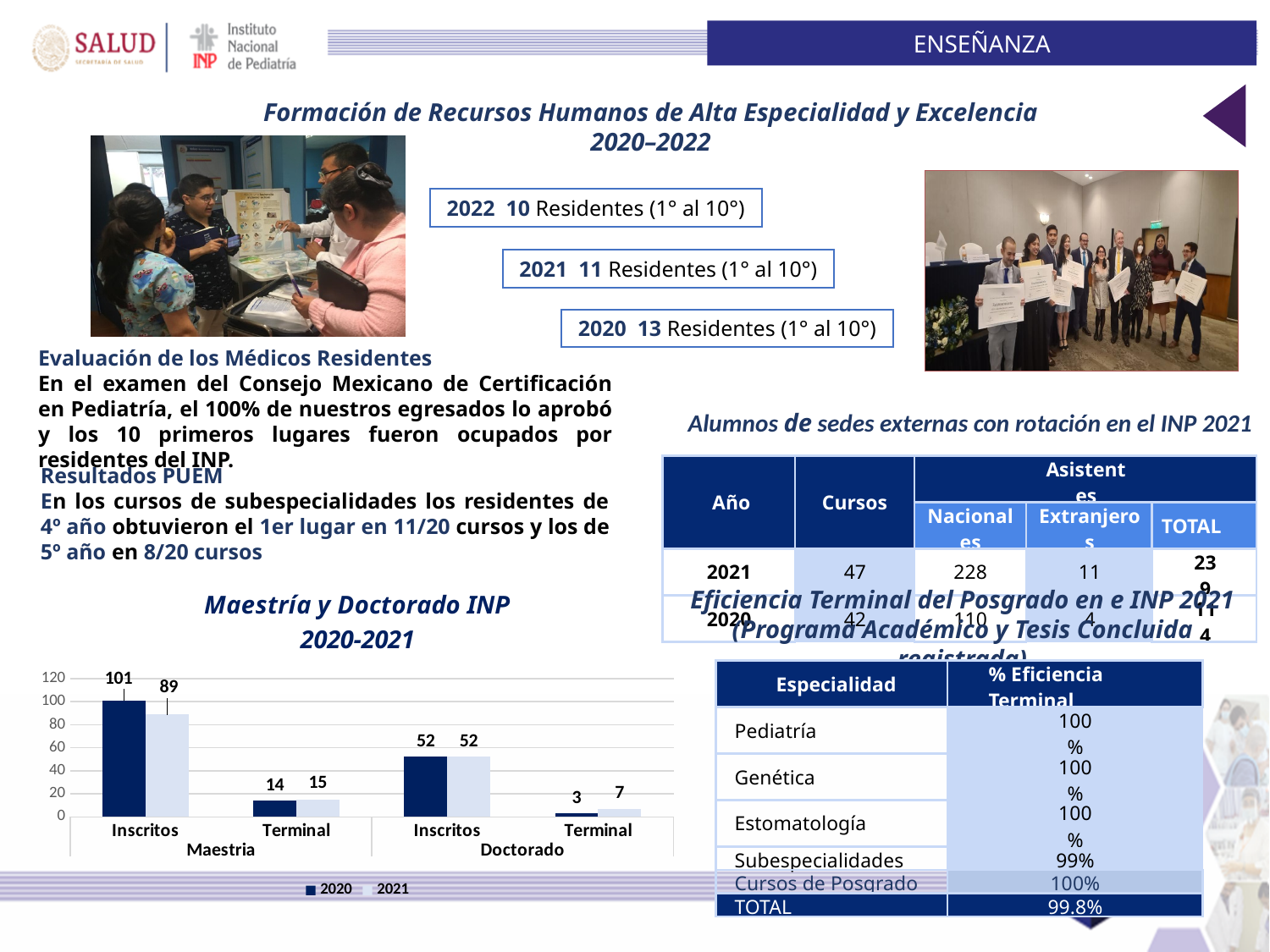
In the 'Maestría y Doctorado INP 2020-2021' chart, which category has the lowest 2020 value? Terminal (Doctorado) In the 'Maestría y Doctorado INP 2020-2021' chart, how many series does the legend list? 2 In the 'Maestría y Doctorado INP 2020-2021' chart, what are the 2020 and 2021 values for Inscritos in Doctorado? 52 and 52 In the 'Maestría y Doctorado INP 2020-2021' chart, what is the 2020 value for Terminal in Maestria? 14 In the 'Maestría y Doctorado INP 2020-2021' chart, which category has the highest 2020 value? Inscritos (Maestria) In the 'Maestría y Doctorado INP 2020-2021' chart, what is the difference between the 2020 and 2021 values for Inscritos in Maestria? 12 In the 'Maestría y Doctorado INP 2020-2021' chart, which is larger for Terminal in Doctorado: the 2020 value or the 2021 value? 2021 In the 'Maestría y Doctorado INP 2020-2021' chart, what is the 2020 value for Inscritos in Maestria? 101 In the 'Maestría y Doctorado INP 2020-2021' chart, what is the 2021 value for Inscritos in Maestria? 89 What kind of chart is 'Maestría y Doctorado INP 2020-2021'? Bar chart In the 'Maestría y Doctorado INP 2020-2021' chart, which series is shown in dark blue? 2020 In the 'Maestría y Doctorado INP 2020-2021' chart, what is the 2021 value for Terminal in Doctorado? 7